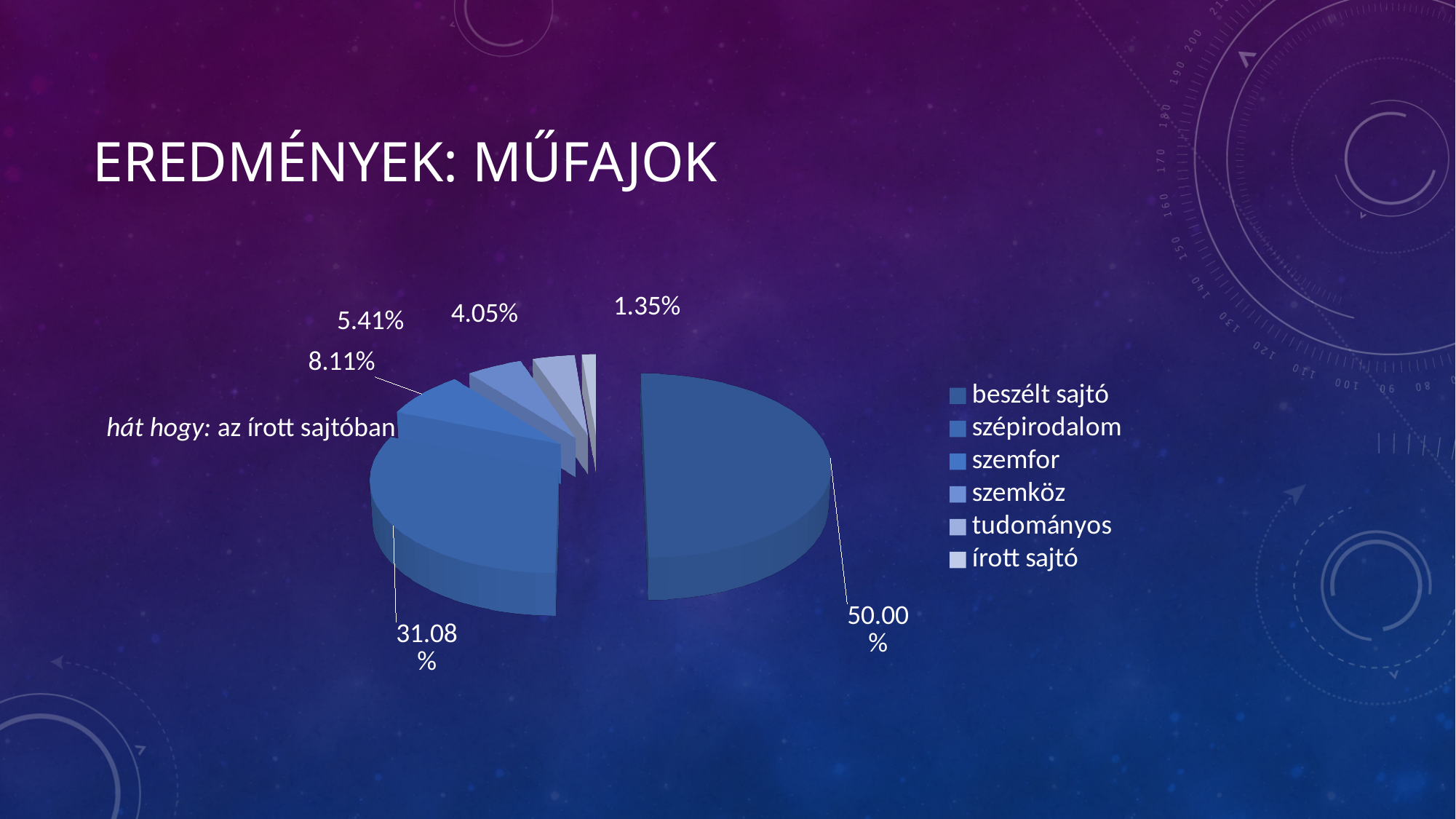
What percentage is shown for írott sajtó? 1.35% How many categories does the legend of the pie chart list? 6 What share of the pie does beszélt sajtó have? 50.00% What is the difference between the shares of szemfor and szemköz? 2.70% What percentage is shown for szemfor? 8.11% Which category has the smallest slice of the pie? írott sajtó What kind of chart is shown on the slide? pie chart What is the title of the slide containing the pie chart? EREDMÉNYEK: MŰFAJOK What is the difference between the shares of beszélt sajtó and szépirodalom? 18.92% Which is larger, the share of szemköz or the share of tudományos? szemköz Which category has the largest slice of the pie? beszélt sajtó What share of the pie does szépirodalom have? 31.08%